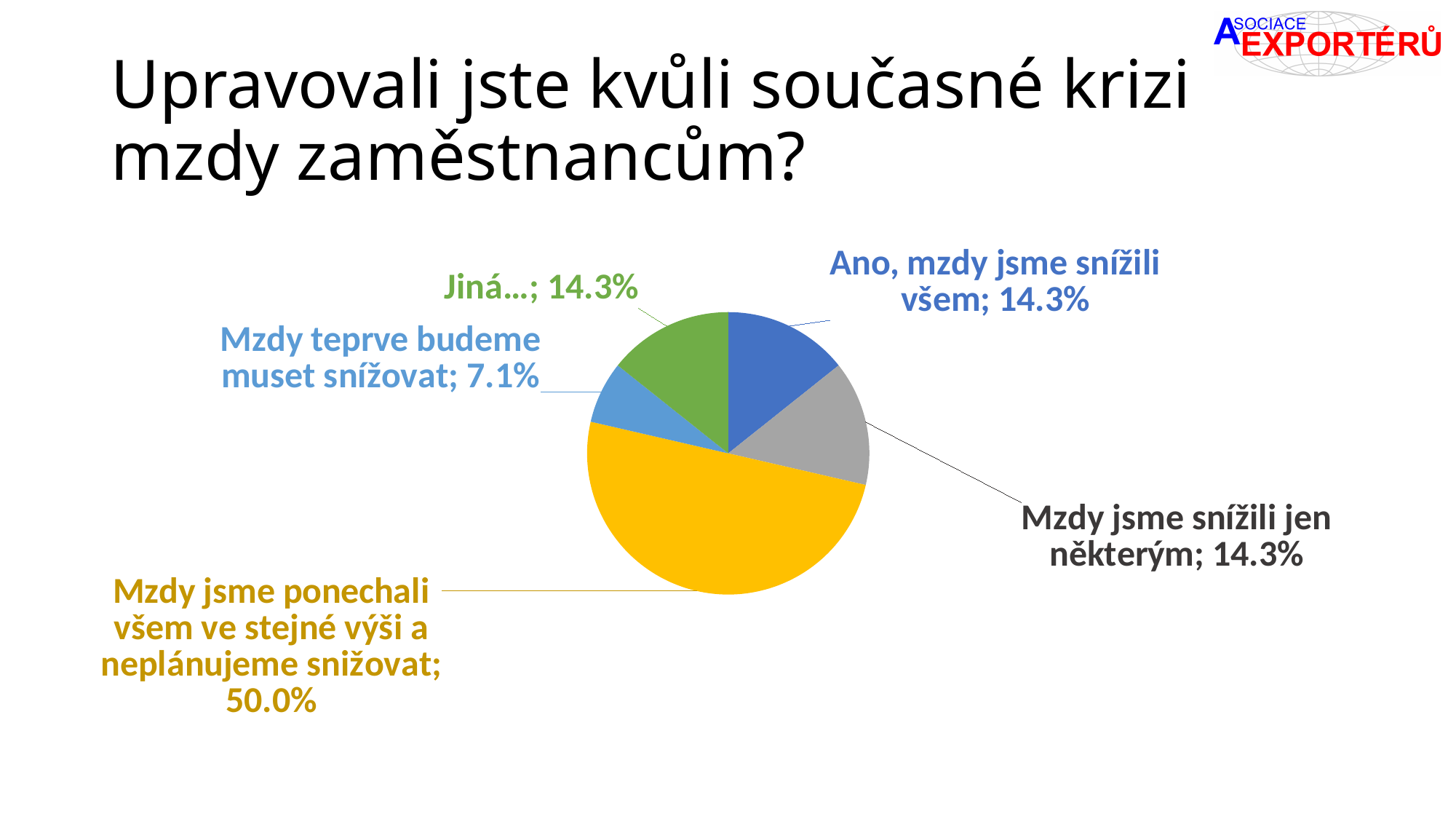
What is the value for 'Jiná…'? 14.3% Which category has the largest share of the pie? Mzdy jsme ponechali všem ve stejné výši a neplánujeme snižovat How many slices does the pie chart have? 5 What is the value for 'Mzdy teprve budeme muset snižovat'? 7.1% What colour is the slice for 'Mzdy jsme snížili jen některým'? grey What is the title of the slide above the chart? Upravovali jste kvůli současné krizi mzdy zaměstnancům? What is the value for 'Ano, mzdy jsme snížili všem'? 14.3% What share of the pie is 'Mzdy jsme ponechali všem ve stejné výši a neplánujeme snižovat'? 50.0% Which is larger: the share for 'Ano, mzdy jsme snížili všem' or 'Mzdy teprve budeme muset snižovat'? Ano, mzdy jsme snížili všem What kind of chart is shown on the slide? pie chart Which category has the smallest share of the pie? Mzdy teprve budeme muset snižovat What is the difference between the share for 'Mzdy jsme ponechali všem ve stejné výši a neplánujeme snižovat' and 'Mzdy jsme snížili jen některým'? 35.7%